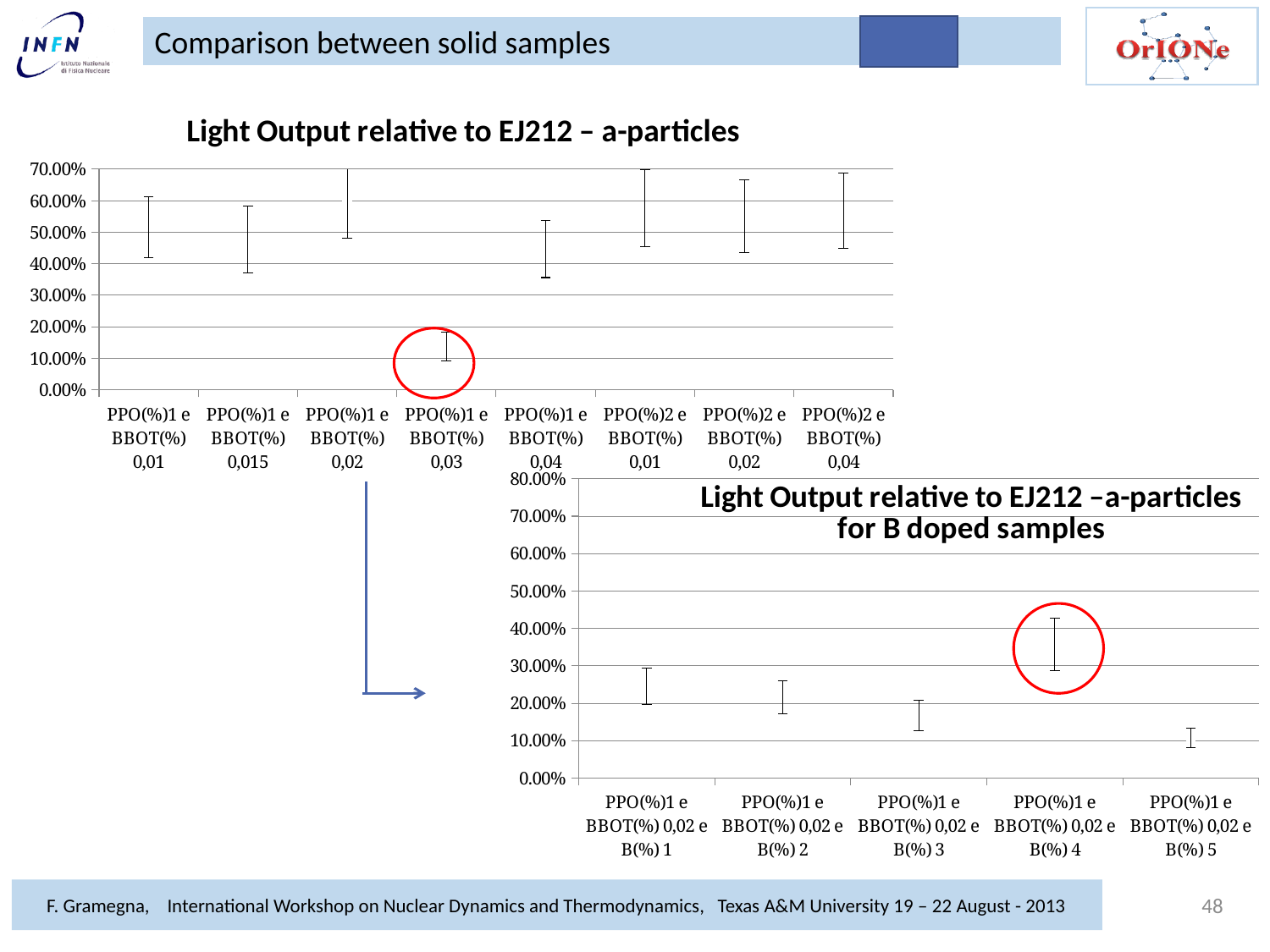
In the lower chart 'Light Output relative to EJ212 – a-particles for B doped samples', how many sample categories are plotted? 5 In the top chart 'Light Output relative to EJ212 – a-particles', which sample is circled in red? PPO(%)1 e BBOT(%) 0,03 In the lower chart for B doped samples, is the value for PPO(%)1 e BBOT(%) 0,02 e B(%) 4 greater or less than 20.00%? greater In the lower chart for B doped samples, is the value for PPO(%)1 e BBOT(%) 0,02 e B(%) 5 greater or less than 20.00%? less In the top chart 'Light Output relative to EJ212 – a-particles', is the value for PPO(%)1 e BBOT(%) 0,03 greater or less than 30.00%? less In the lower chart for B doped samples, which sample has the lowest light output? PPO(%)1 e BBOT(%) 0,02 e B(%) 5 In the lower chart for B doped samples, which is larger: the value for B(%) 1 or the value for B(%) 5? B(%) 1 In the top chart 'Light Output relative to EJ212 – a-particles', which is larger: the value for PPO(%)1 e BBOT(%) 0,03 or the value for PPO(%)2 e BBOT(%) 0,01? PPO(%)2 e BBOT(%) 0,01 In the lower chart for B doped samples, which sample has the highest light output? PPO(%)1 e BBOT(%) 0,02 e B(%) 4 What is the title of the lower chart on the slide? Light Output relative to EJ212 –a-particles for B doped samples In the top chart 'Light Output relative to EJ212 – a-particles', which sample has the lowest light output? PPO(%)1 e BBOT(%) 0,03 In the top chart 'Light Output relative to EJ212 – a-particles', how many sample categories are plotted along the x axis? 8